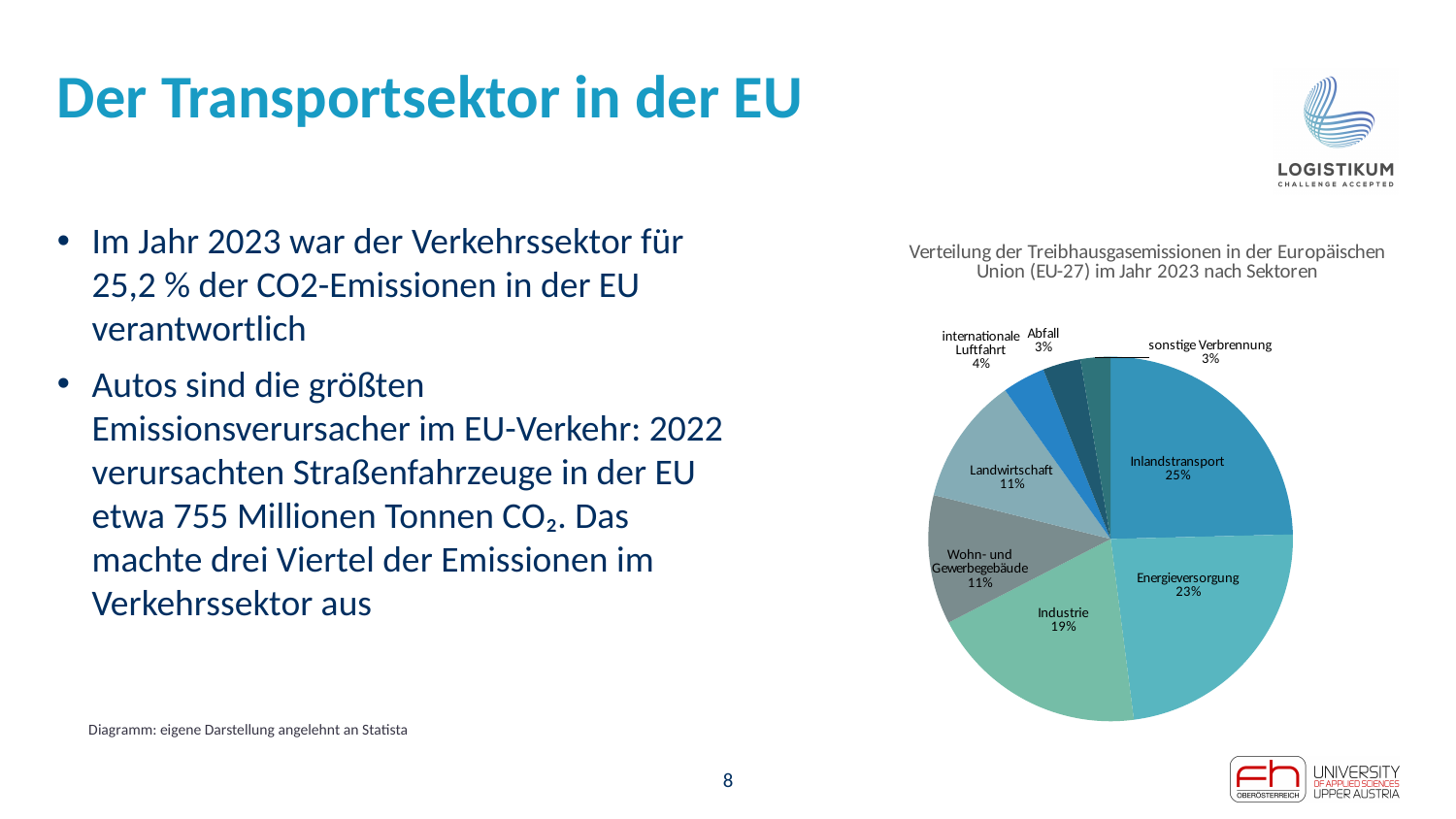
What kind of chart is shown on the slide? pie chart What share of the pie does Abfall have? 3% Which has a larger share, Industrie or Wohn- und Gewerbegebäude? Industrie What share of the pie does Industrie have? 19% How many sectors (slices) are shown in the pie chart? 8 What is the title of the chart? Verteilung der Treibhausgasemissionen in der Europäischen Union (EU-27) im Jahr 2023 nach Sektoren What share of the pie does Landwirtschaft have? 11% What share of the pie does internationale Luftfahrt have? 4% What share of the pie does Energieversorgung have? 23% What is the difference in percentage points between the shares of Inlandstransport and Energieversorgung? 2 percentage points Which sector has the largest share of the pie? Inlandstransport What share of the pie does Inlandstransport have? 25%